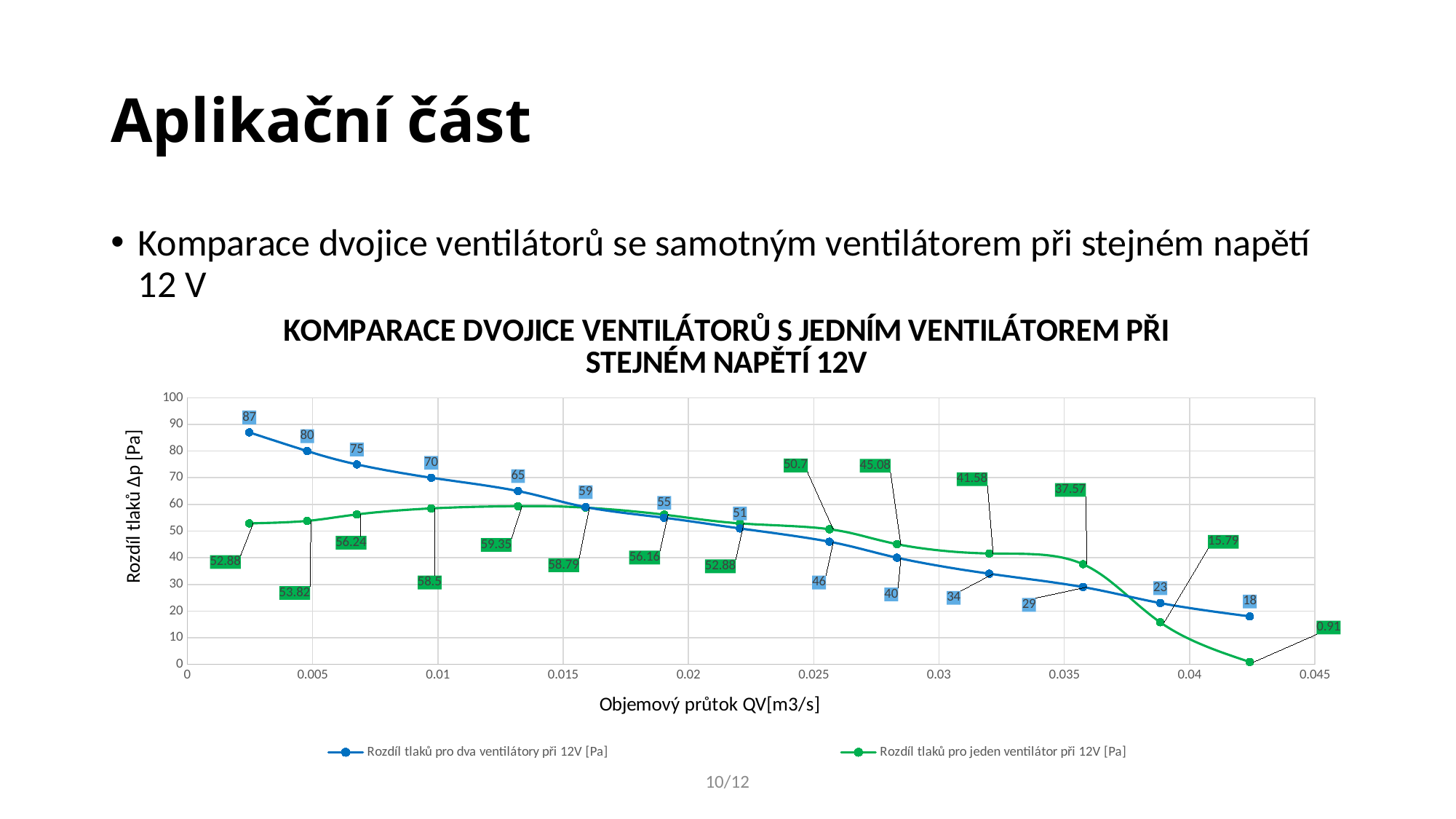
What is the lowest value in the series 'Rozdíl tlaků pro dva ventilátory při 12V [Pa]'? 18 How many series does the legend list? 2 What is the highest value in the series 'Rozdíl tlaků pro jeden ventilátor při 12V [Pa]'? 59.35 What is the lowest value in the series 'Rozdíl tlaků pro jeden ventilátor při 12V [Pa]'? 0.91 What is the label of the x axis of the chart? Objemový průtok QV[m3/s] What is the first (leftmost) data label of the series 'Rozdíl tlaků pro jeden ventilátor při 12V [Pa]'? 52.88 What kind of chart is shown on the slide? Line chart Which series has the larger value at the leftmost data point: the two-fan series (87) or the single-fan series (52.88)? Rozdíl tlaků pro dva ventilátory při 12V [Pa] How many data points are plotted for the series 'Rozdíl tlaků pro dva ventilátory při 12V [Pa]'? 14 What is the difference between the highest value of the two-fan series (87) and the highest value of the single-fan series (59.35)? 27.65 Do the values of the series 'Rozdíl tlaků pro dva ventilátory při 12V [Pa]' rise or fall as the volumetric flow increases along the x axis? Fall What is the highest value in the series 'Rozdíl tlaků pro dva ventilátory při 12V [Pa]'? 87